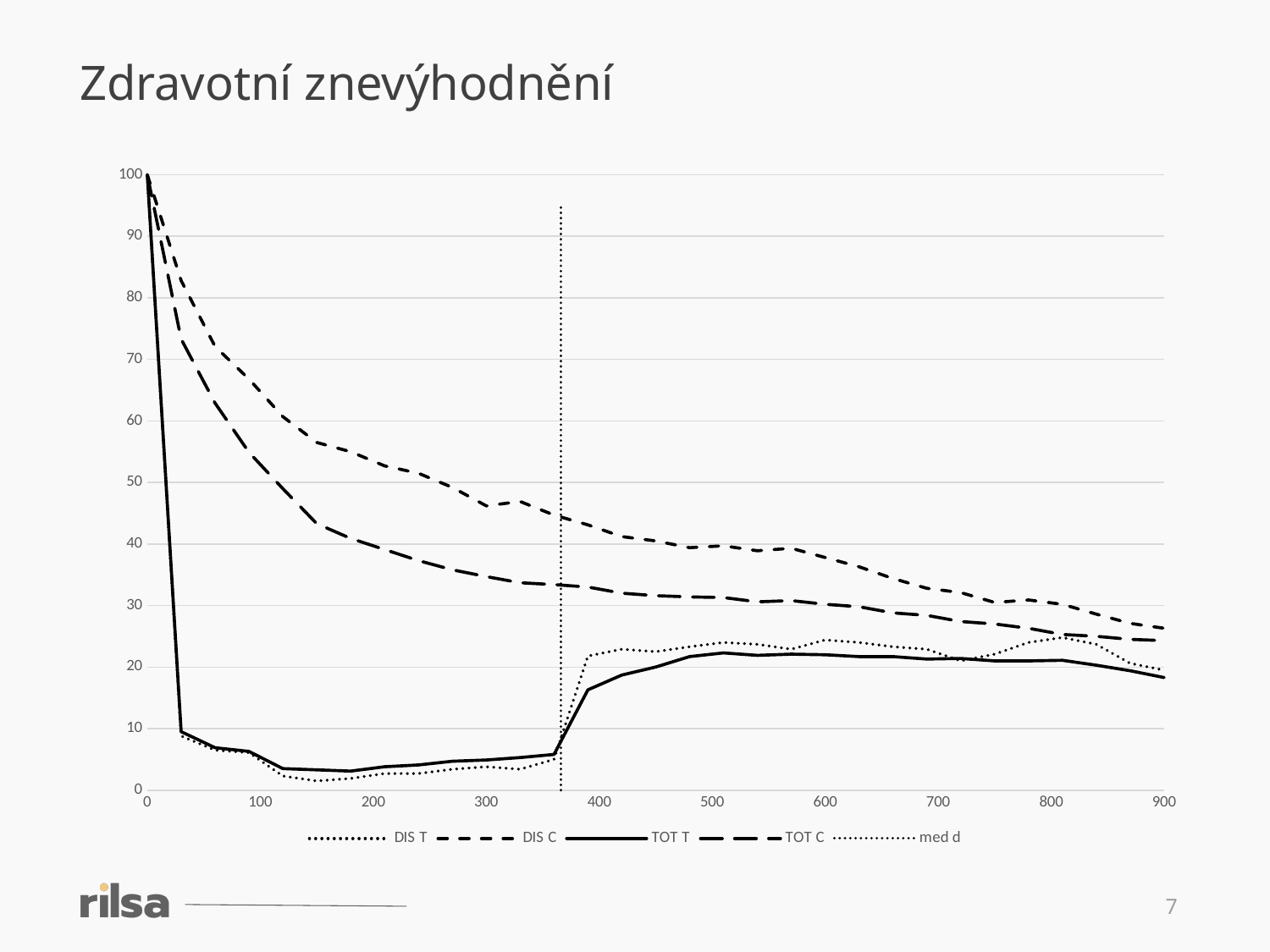
Is the value of DIS C at x = 900 greater or less than 20? greater Is the value of DIS C at x = 100 greater or less than 60? greater At x = 900, which series has the larger value, DIS C or TOT T? DIS C How many series does the legend list? 5 What is the title of the slide containing the chart? Zdravotní znevýhodnění Is the value of TOT T at x = 200 greater or less than 10? less What kind of chart is shown on the slide? line chart Does the DIS C series rise or fall as x increases from 0 to 900? fall What is the value of the DIS C series at x = 0? 100 Which series in the legend is drawn as a solid line? TOT T